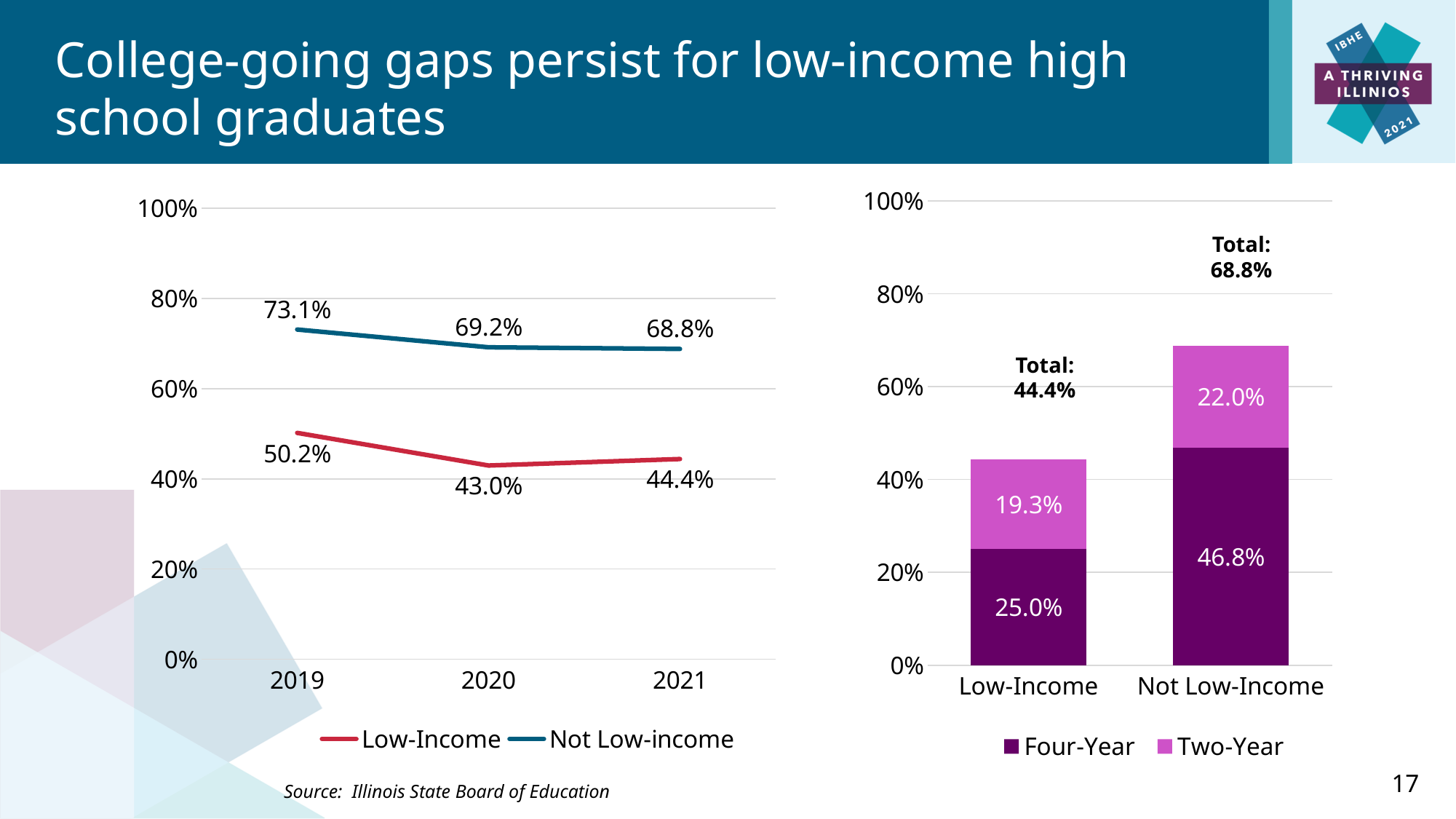
In the line chart on the left, how many series does the legend list? 2 In the line chart on the left, what is the value for Low-Income in 2019? 50.2% In the line chart on the left, how many years are shown on the x axis? 3 In the line chart on the left, what is the difference between Not Low-income and Low-Income in 2020? 26.2% In the line chart on the left, which year has the lowest Low-Income value? 2020 In the bar chart on the right, what is the Four-Year value for Not Low-Income? 46.8% In the line chart on the left, what is the value for Not Low-income in 2021? 68.8% In the bar chart on the right, what is the total for the Low-Income bar? 44.4% What kind of chart is on the right side of the slide? stacked bar chart In the bar chart on the right, what colour represents Four-Year in the legend? dark purple In the line chart on the left, does the Not Low-income line rise or fall from 2019 to 2021? fall In the bar chart on the right, which category has the larger Two-Year value, Low-Income or Not Low-Income? Not Low-Income